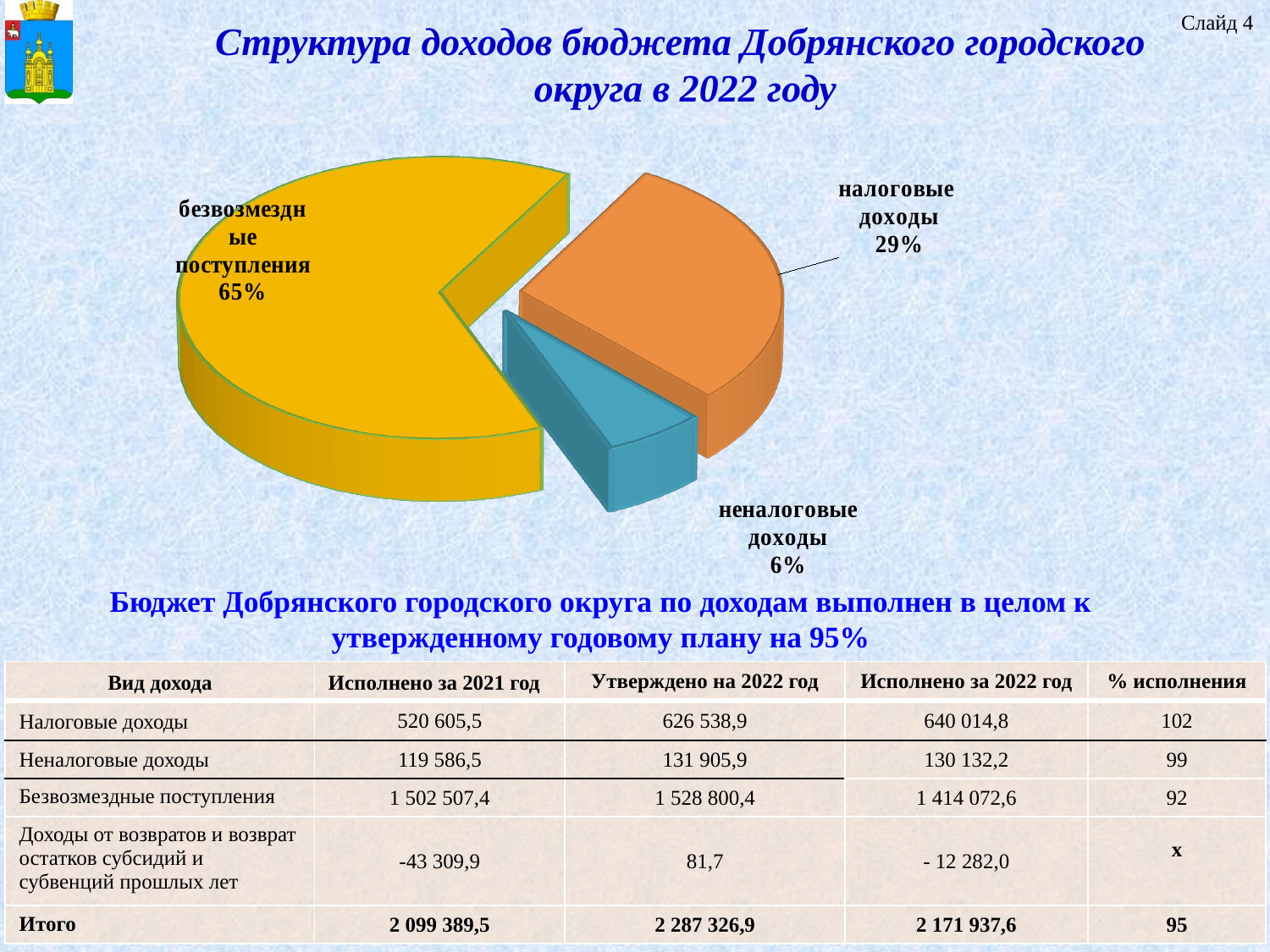
What type of chart is shown on the slide? pie chart Which category has the smallest slice in the pie chart? неналоговые доходы What percentage does the pie chart show for налоговые доходы? 29% By how many percentage points does the share of налоговые доходы exceed the share of неналоговые доходы? 23 percentage points Which category has the largest slice in the pie chart? безвозмездные поступления How many slices does the pie chart have? 3 By how many percentage points does the share of безвозмездные поступления exceed the share of налоговые доходы? 36 percentage points What percentage does the pie chart show for неналоговые доходы? 6% What share of the pie chart is labelled for безвозмездные поступления? 65% What colour is the slice for неналоговые доходы? blue What colour is the slice for безвозмездные поступления? yellow Which is larger in the pie chart: налоговые доходы or неналоговые доходы? налоговые доходы